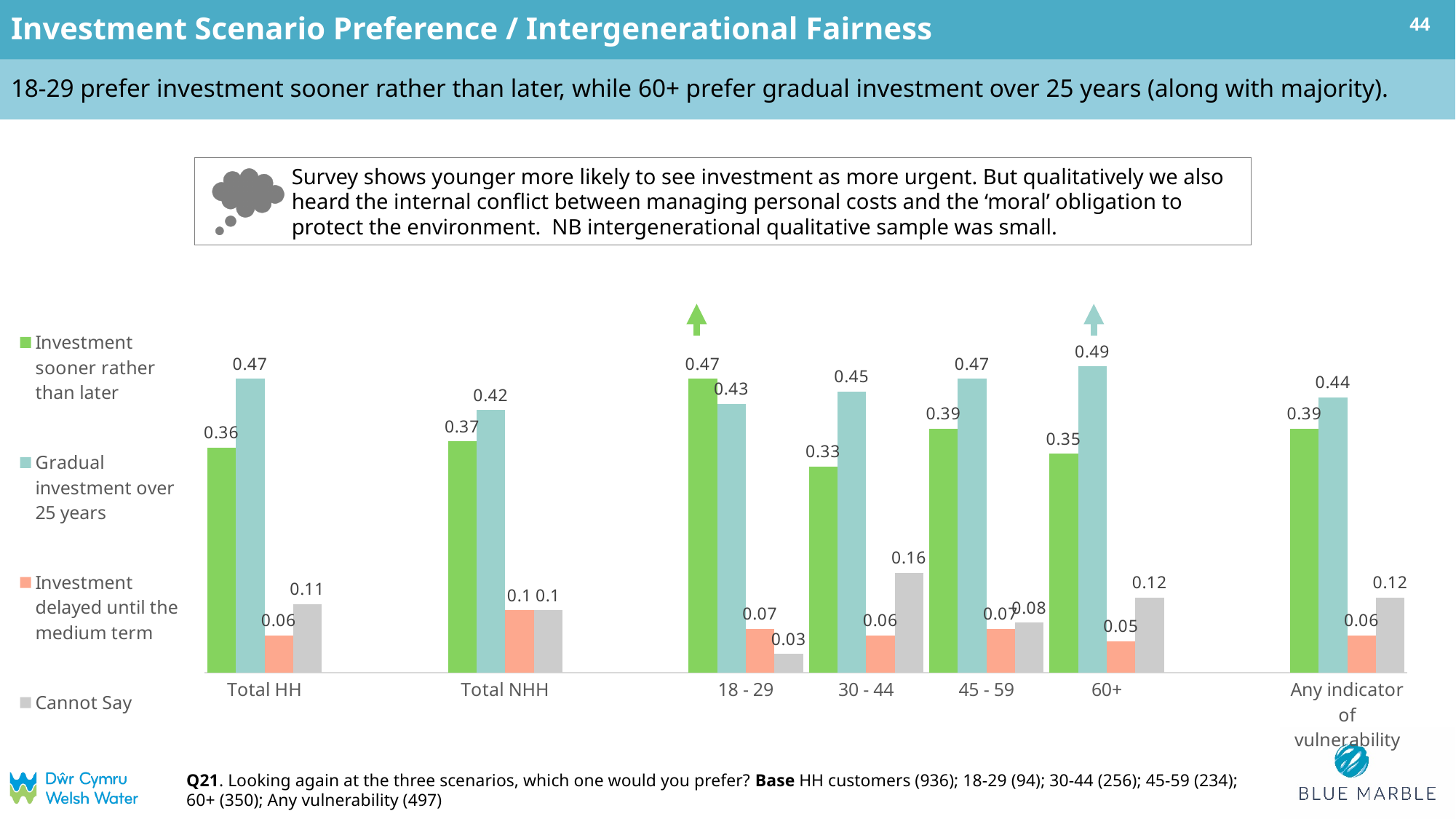
In the 18 - 29 category, which is larger: 'Investment sooner rather than later' or 'Gradual investment over 25 years'? Investment sooner rather than later For Total HH, what is the difference between 'Gradual investment over 25 years' and 'Investment sooner rather than later'? 0.11 Which category has the highest value for 'Gradual investment over 25 years'? 60+ Which category has the lowest 'Cannot Say' value? 18 - 29 What is the value for 'Investment delayed until the medium term' for Total NHH? 0.1 Which category has the highest value for 'Investment sooner rather than later'? 18 - 29 What type of chart is shown on the slide? Bar chart What is the value for 'Investment sooner rather than later' in the 18 - 29 category? 0.47 How many categories are shown on the x axis of the chart? 7 What is the value for 'Gradual investment over 25 years' in the 60+ category? 0.49 What is the 'Cannot Say' value for the 30 - 44 category? 0.16 How many series does the chart legend list? 4